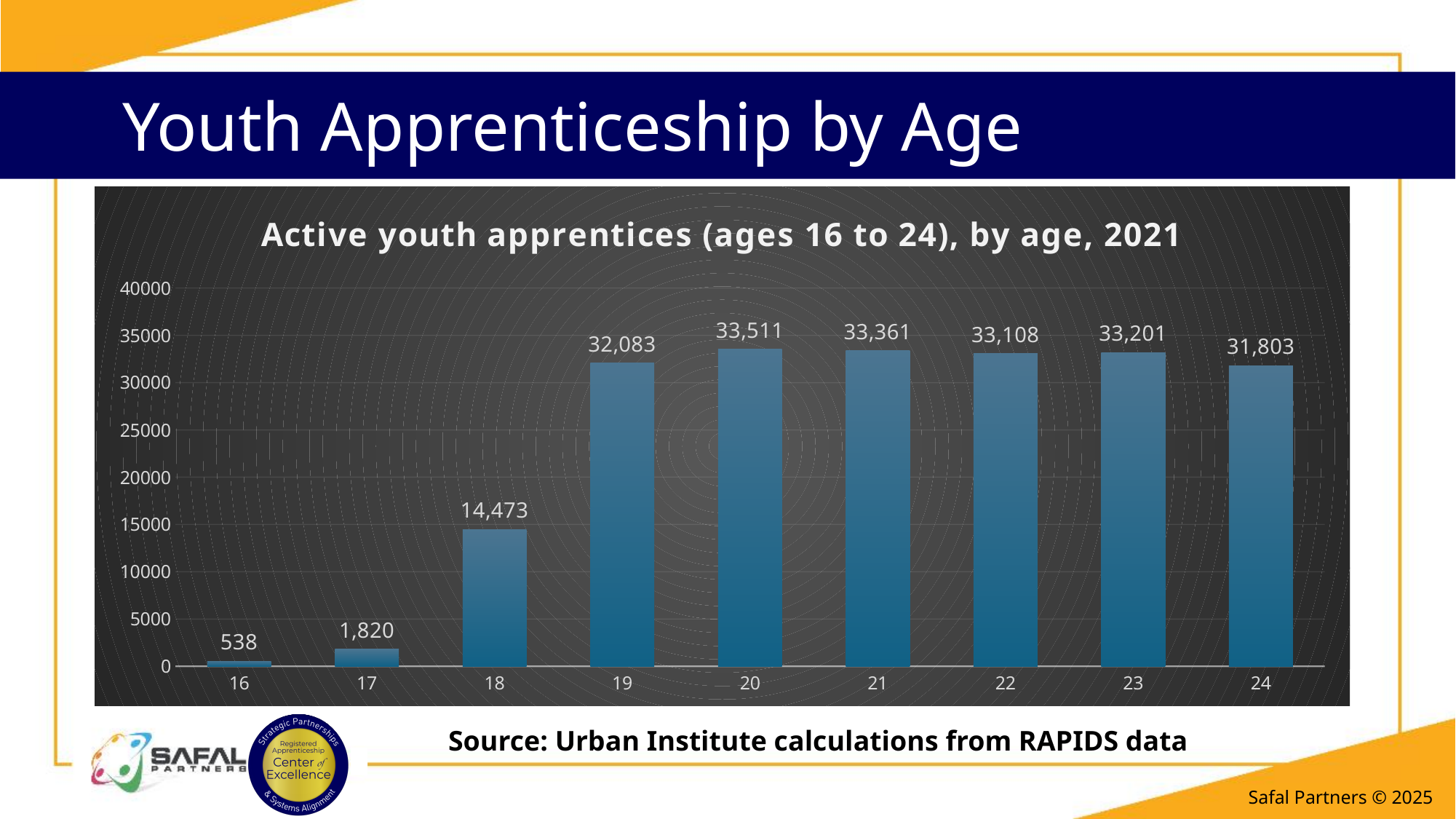
Which age has the highest number of active youth apprentices? 20 What is the difference between the number of active youth apprentices at age 17 and at age 16? 1,282 What is the number of active youth apprentices at age 16? 538 Is the value for age 18 greater or less than 15000? less What kind of chart is shown on the slide? Bar chart How many age categories are shown on the x axis? 9 What is the difference between the number of active youth apprentices at age 19 and at age 18? 17,610 What is the number of active youth apprentices at age 18? 14,473 What is the number of active youth apprentices at age 24? 31,803 Which age has the lowest number of active youth apprentices? 16 What is the title of the chart? Active youth apprentices (ages 16 to 24), by age, 2021 Which age has more active youth apprentices, 22 or 23? 23